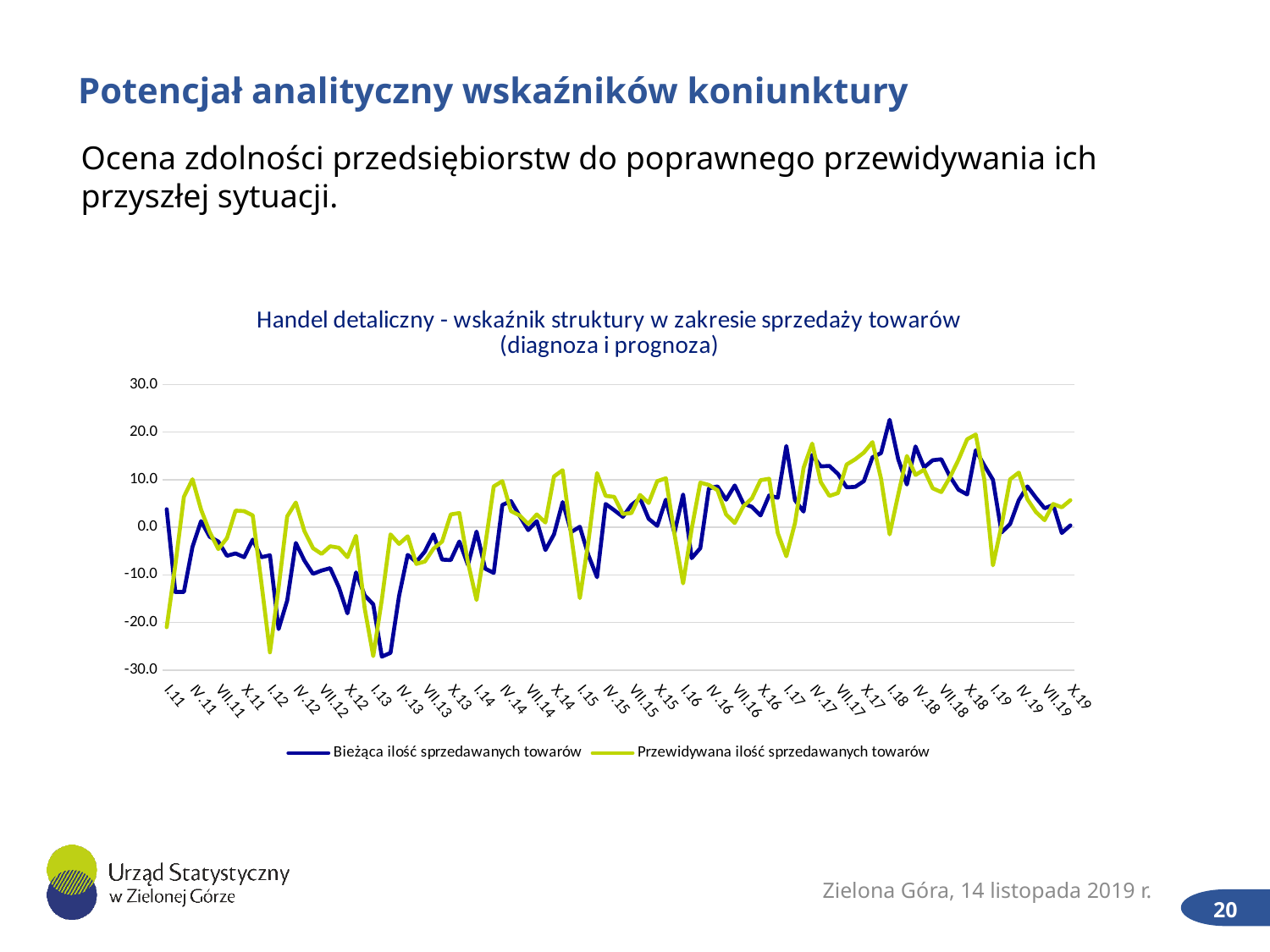
Which series reaches the highest value on the chart? Bieżąca ilość sprzedawanych towarów What kind of chart is shown on the slide? line chart How many series does the legend list? 2 Is the value of Przewidywana ilość sprzedawanych towarów at I.12 greater or less than -20.0? less What are the two series named in the legend? Bieżąca ilość sprzedawanych towarów; Przewidywana ilość sprzedawanych towarów What is the title of the chart? Handel detaliczny - wskaźnik struktury w zakresie sprzedaży towarów (diagnoza i prognoza) Is the value of Przewidywana ilość sprzedawanych towarów at I.15 greater or less than -10.0? less Is the value of Przewidywana ilość sprzedawanych towarów at I.13 greater or less than -20.0? less Do the values generally rise or fall from I.11 to X.19? rise